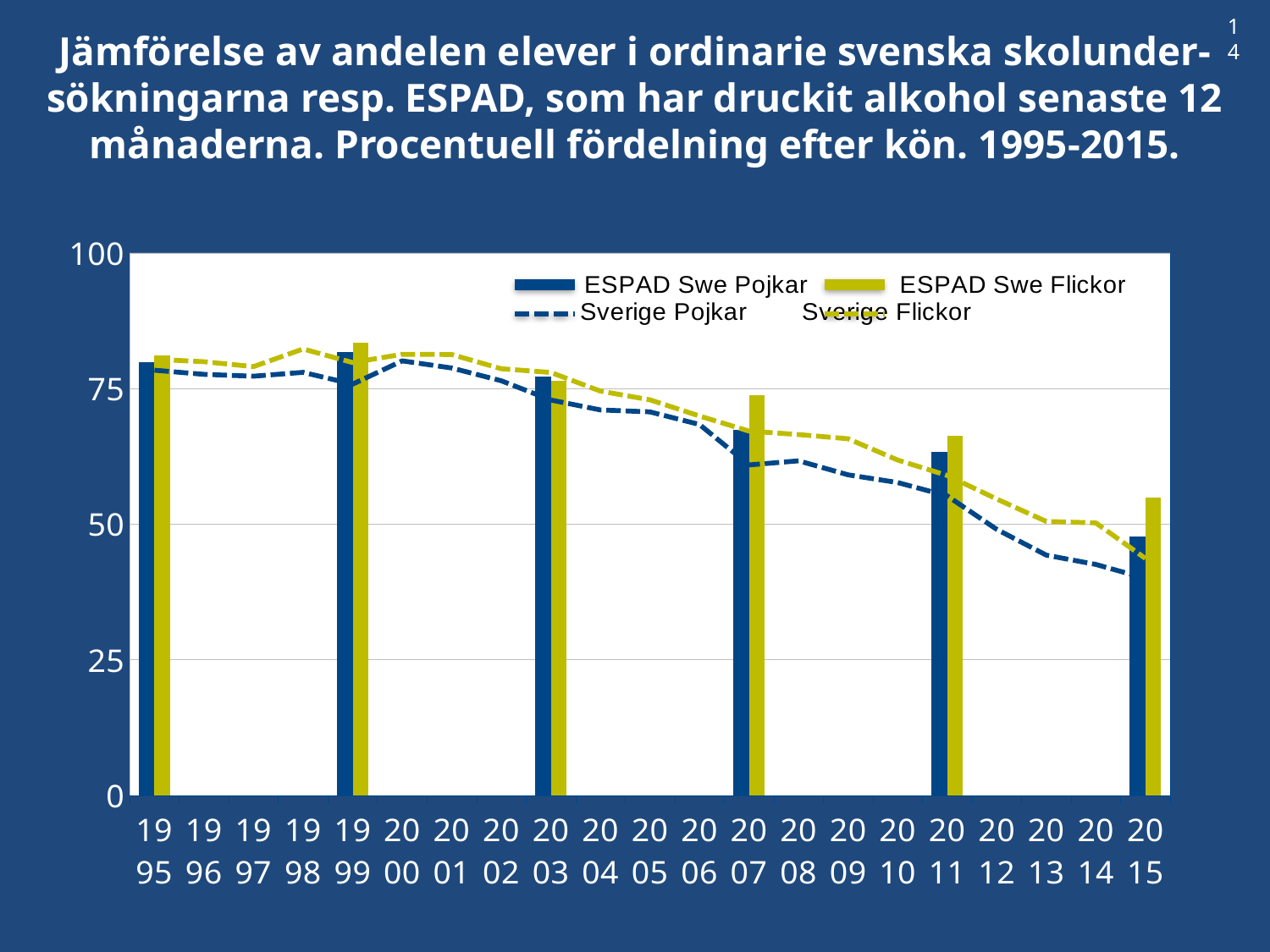
What kind of chart is this? Combined bar and line chart How many series does the legend list? 4 In 2015, which is larger: ESPAD Swe Pojkar or ESPAD Swe Flickor? ESPAD Swe Flickor Is the value for Sverige Pojkar in 2015 greater or less than 50? less Is the value for ESPAD Swe Pojkar in 2011 greater or less than 50? greater Is the value for ESPAD Swe Flickor in 1999 greater or less than 75? greater In which year is the ESPAD Swe Pojkar bar lowest? 2015 Do the Sverige Pojkar and Sverige Flickor lines generally rise or fall from 1995 to 2015? Fall Which series are drawn as dashed lines rather than bars? Sverige Pojkar and Sverige Flickor In how many years are bars plotted for the ESPAD series? 6 How many years are labelled along the x axis? 21